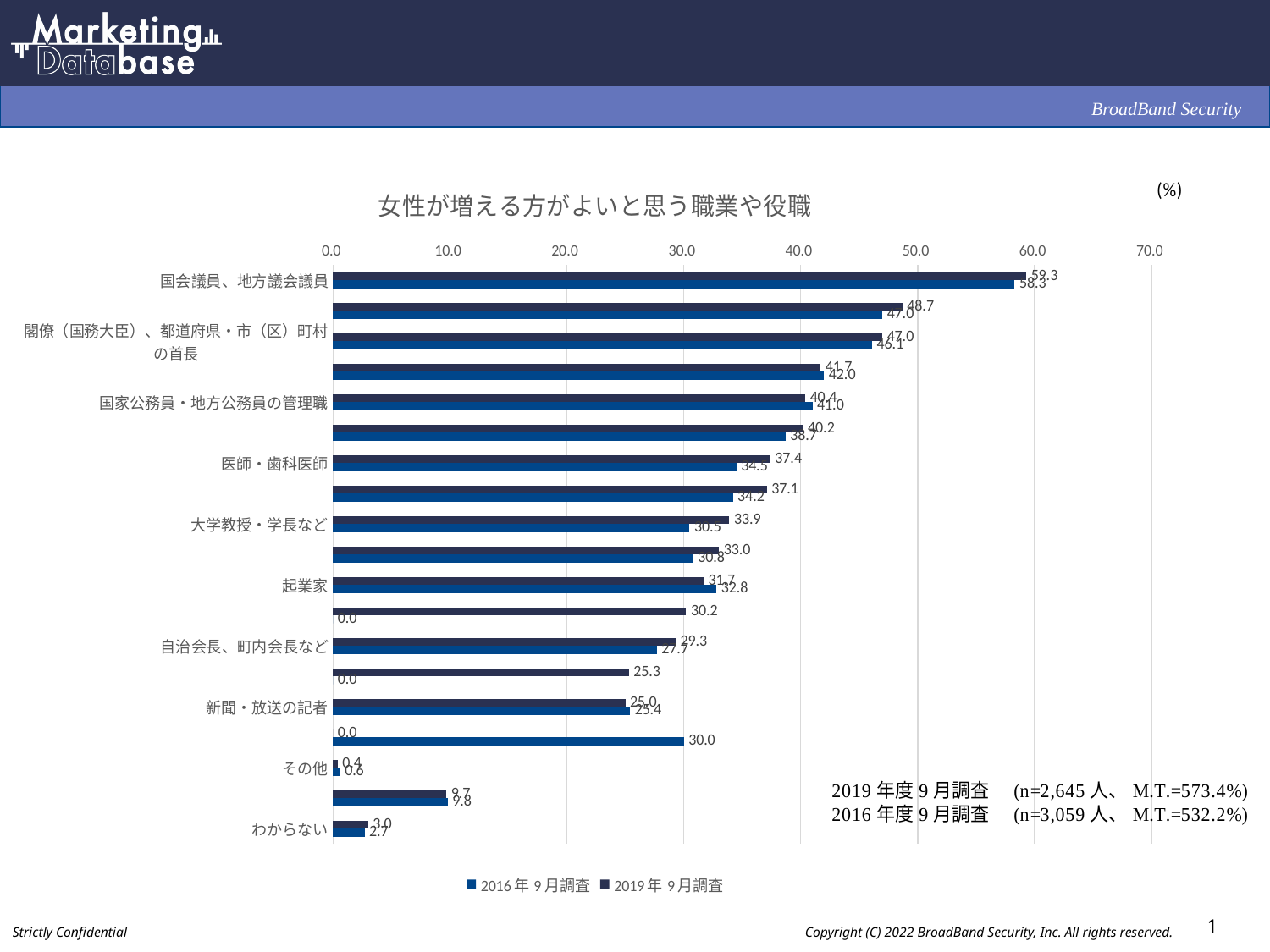
What is the 2019年9月調査 value for 医師・歯科医師? 37.4 What kind of chart is shown on the slide? bar chart Is the value for 国家公務員・地方公務員の管理職 greater or less than 30.0? greater Is the value for わからない greater or less than 10.0? less What is the difference between the 2019年9月調査 and 2016年9月調査 values for 国会議員、地方議会議員? 1.0 Which category has larger values, 医師・歯科医師 or 起業家? 医師・歯科医師 How many series does the chart legend list? 2 What is the 2016年9月調査 value for 国会議員、地方議会議員? 58.3 What is the title of the chart? 女性が増える方がよいと思う職業や役職 What is the 2019年9月調査 value for 国会議員、地方議会議員? 59.3 Which category has the highest value in the chart? 国会議員、地方議会議員 Which two series are listed in the chart legend? 2016年9月調査 and 2019年9月調査